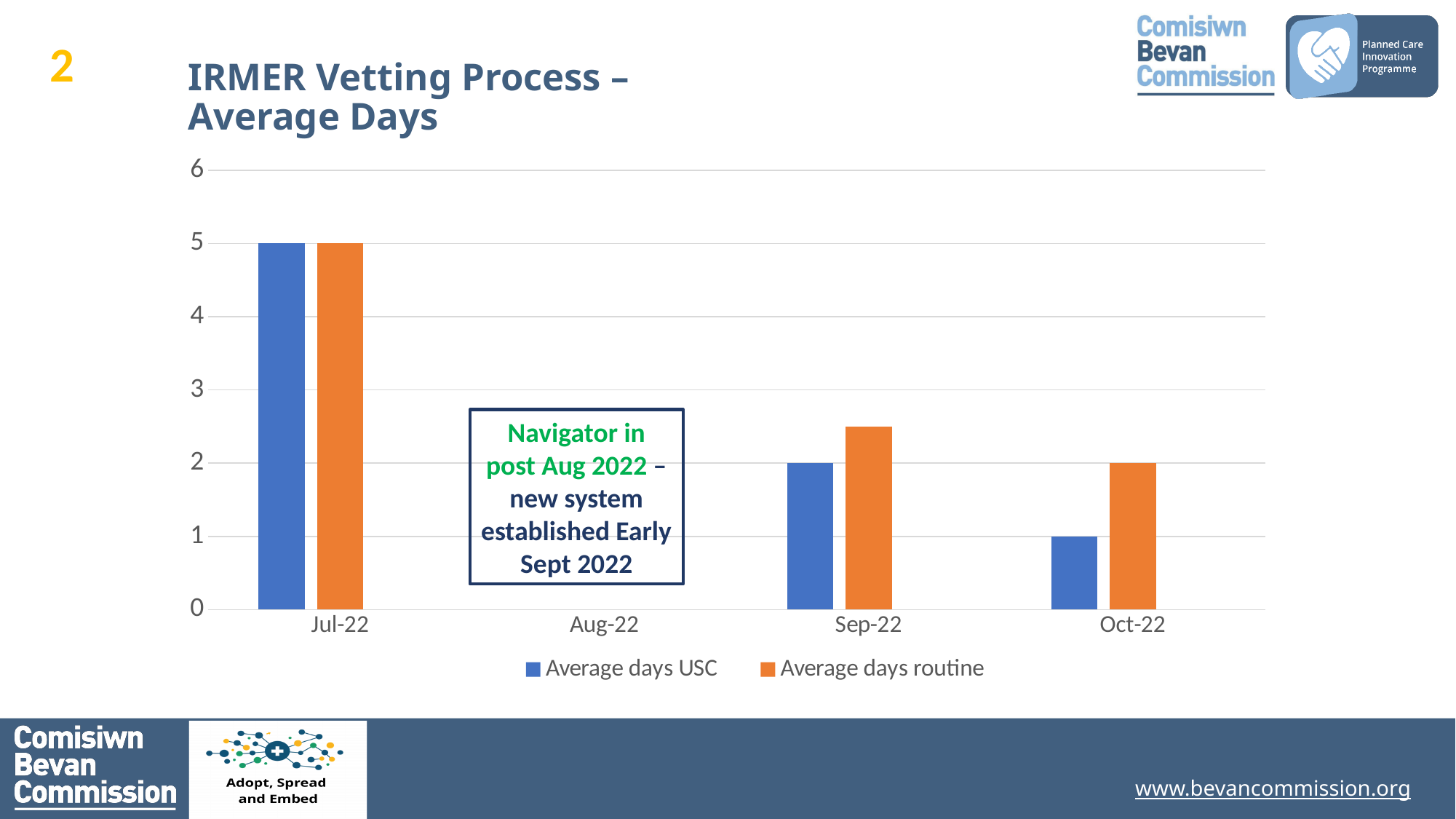
What is the value for Average days routine in Jul-22? 5 What kind of chart is shown on the slide? bar chart What is the value for Average days USC in Jul-22? 5 How many months are shown on the x axis? 4 Which month on the x axis has no bars plotted? Aug-22 What is the value for Average days routine in Oct-22? 2 What is the value for Average days USC in Oct-22? 1 Is the value for Average days routine in Sep-22 greater or less than 2? greater How many series does the legend list? 2 What is the difference between Average days USC in Jul-22 and in Oct-22? 4 Which month has the lowest value for Average days USC? Oct-22 What is the value for Average days USC in Sep-22? 2